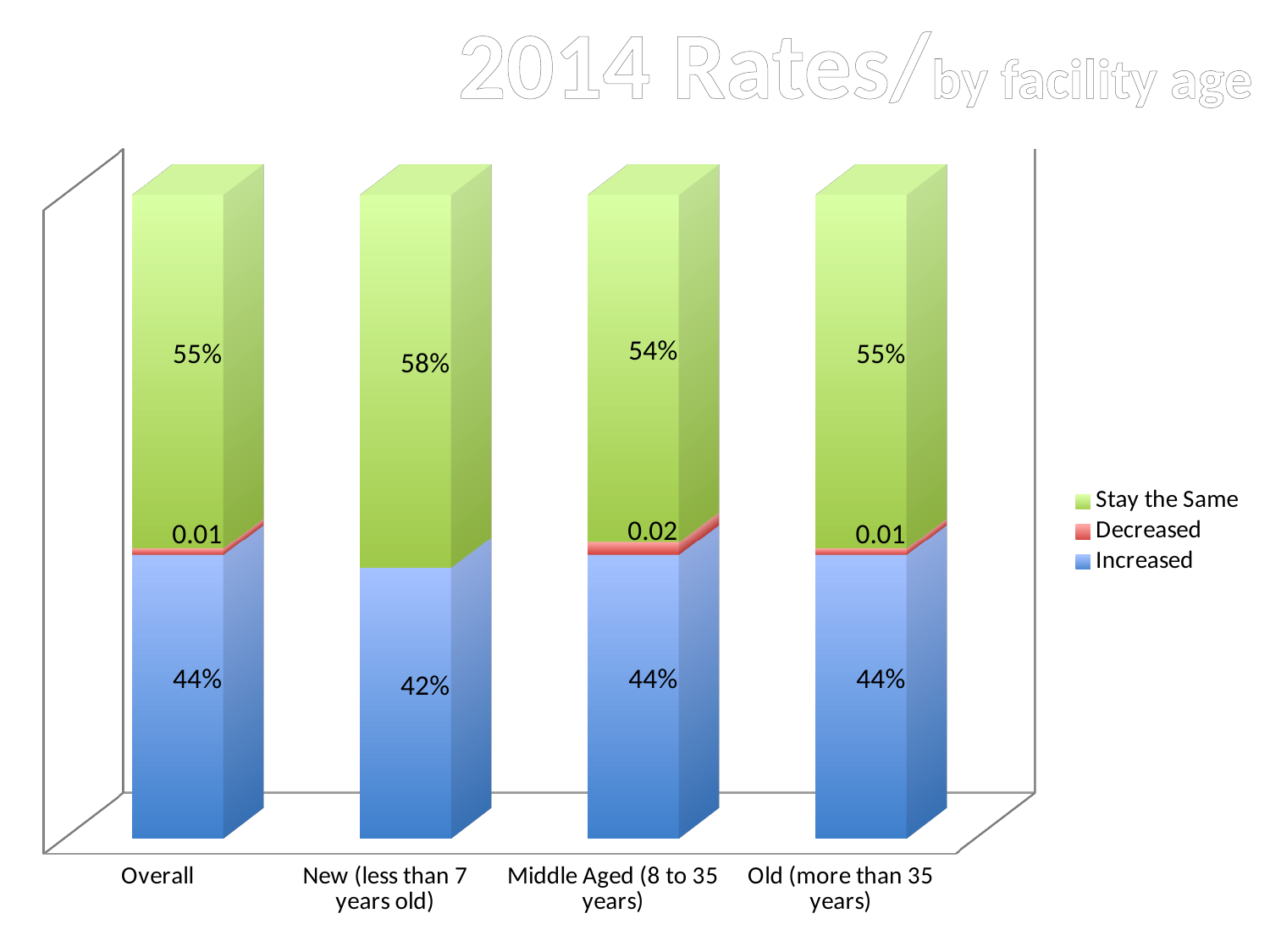
What is the value of the Stay the Same segment for the New (less than 7 years old) category? 58% How many categories are shown on the x axis? 4 Which category has the highest Stay the Same value? New (less than 7 years old) What is the value of the Increased segment for the Overall category? 44% How many series does the legend list? 3 What kind of chart is shown on the slide? Stacked bar chart What is the value of the Decreased segment for the Old (more than 35 years) category? 0.01 For the Overall category, which is larger: the Increased segment or the Stay the Same segment? Stay the Same What is the value of the Decreased segment for the Middle Aged (8 to 35 years) category? 0.02 Which category has the lowest Increased value? New (less than 7 years old) What is the difference between the Stay the Same values for New (less than 7 years old) and Middle Aged (8 to 35 years)? 4 percentage points Which category has the lowest Stay the Same value? Middle Aged (8 to 35 years)